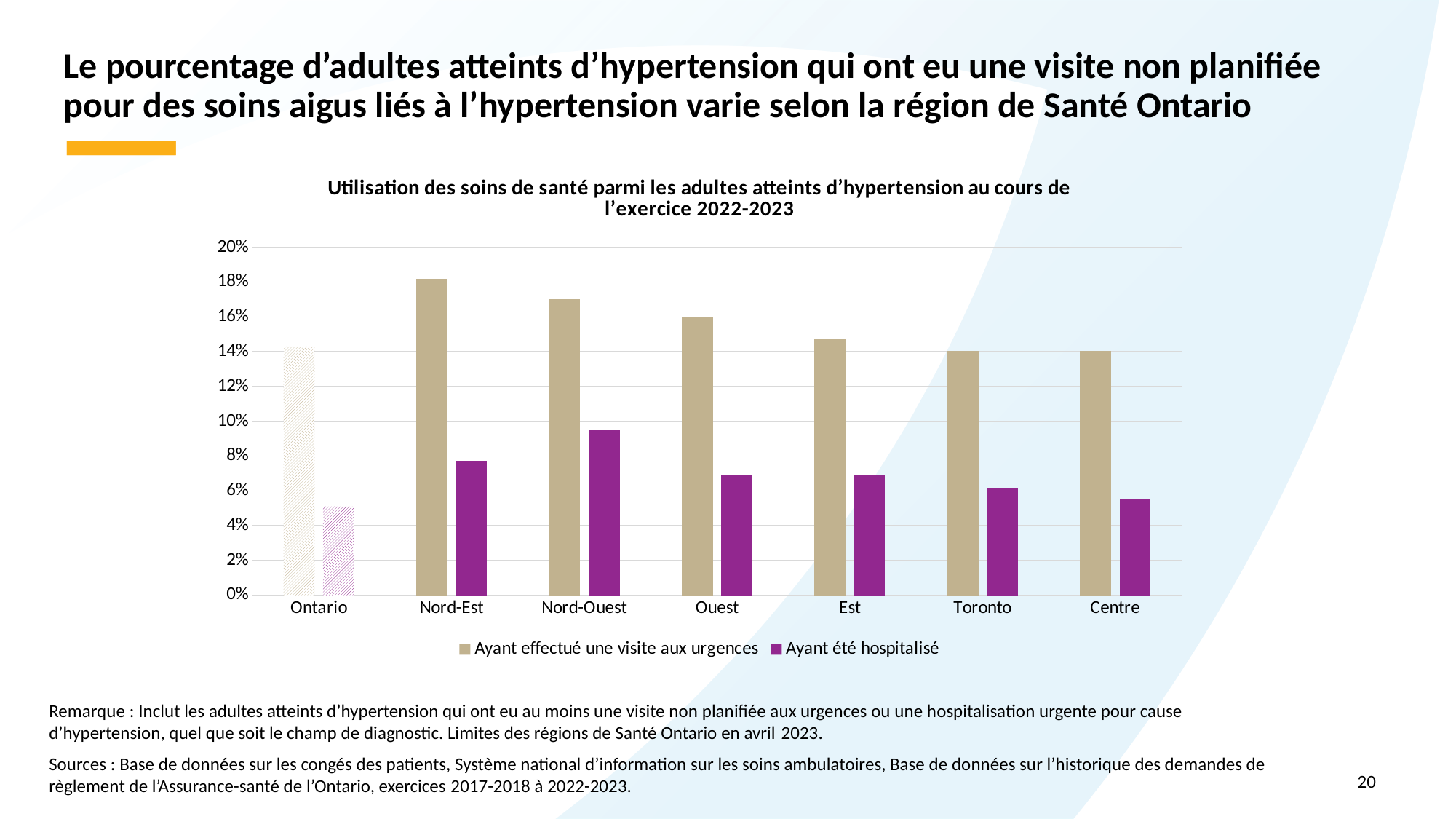
Which region has the highest value for 'Ayant effectué une visite aux urgences'? Nord-Est Which is larger, the 'Ayant été hospitalisé' value for Nord-Est or for Nord-Ouest? Nord-Ouest Which is larger, the 'Ayant effectué une visite aux urgences' value for Nord-Ouest or for Ouest? Nord-Ouest What are the two series named in the chart's legend? Ayant effectué une visite aux urgences; Ayant été hospitalisé How many series does the chart's legend list? 2 How many regions (categories) are shown on the x axis of the chart? 7 What kind of chart is shown on the slide? bar chart Which region has the highest value for 'Ayant été hospitalisé'? Nord-Ouest Is the value for 'Ayant été hospitalisé' in Ontario greater or less than 6%? less Is the value for 'Ayant effectué une visite aux urgences' in Nord-Est greater or less than 16%? greater Is the value for 'Ayant effectué une visite aux urgences' in Est greater or less than 16%? less